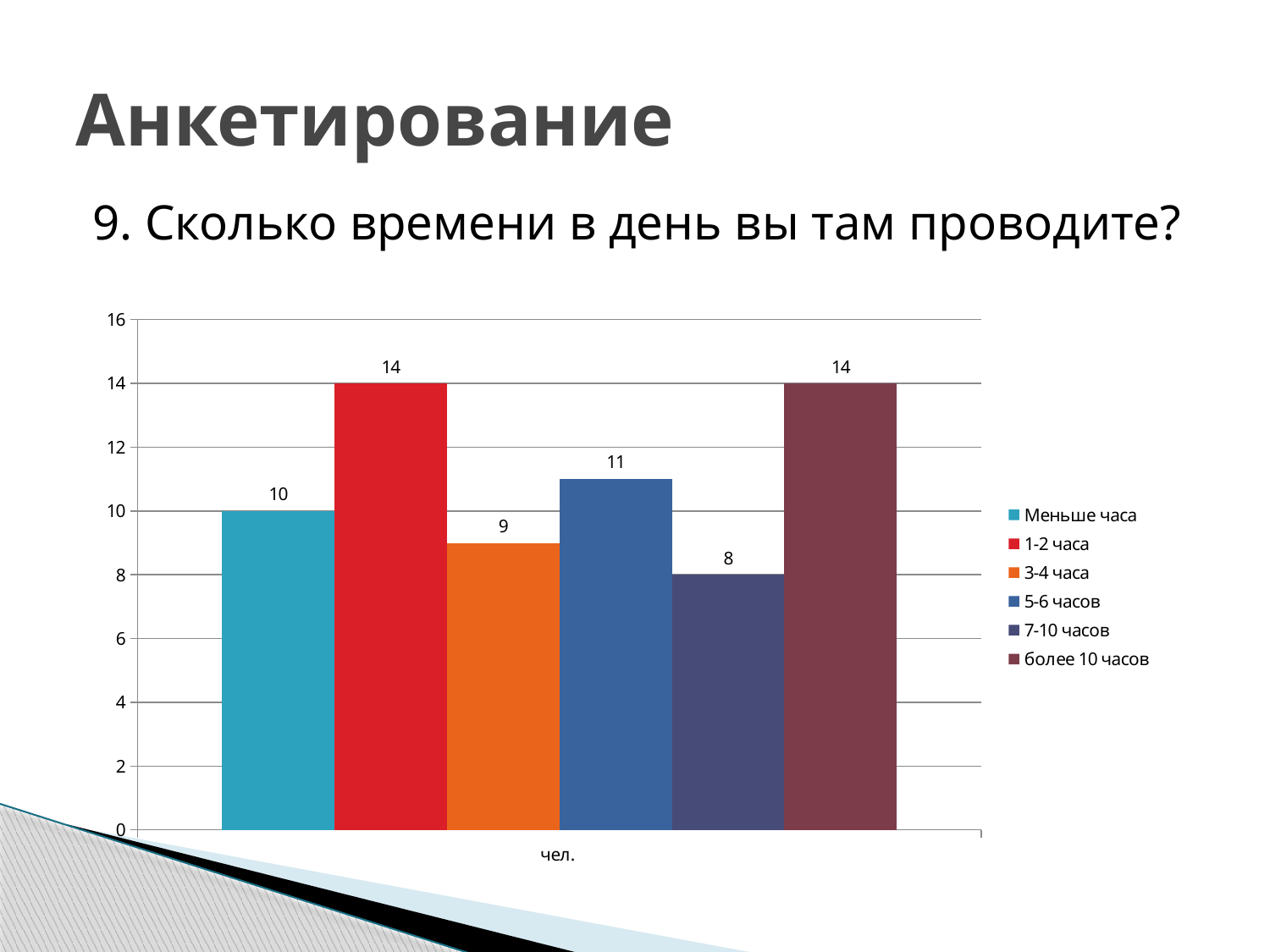
How many series does the legend list? 6 Which legend entry has the lowest value? 7-10 часов What is the difference between the values for "1-2 часа" and "3-4 часа"? 5 What value is shown for "Меньше часа"? 10 What value is shown for "7-10 часов"? 8 What value is shown for "1-2 часа"? 14 What is the label shown on the x axis below the bars? чел. What value is shown for "3-4 часа"? 9 What kind of chart is shown on the slide? bar chart Which is larger, the value for "5-6 часов" or the value for "Меньше часа"? 5-6 часов What value is shown for "более 10 часов"? 14 What value is shown for "5-6 часов"? 11